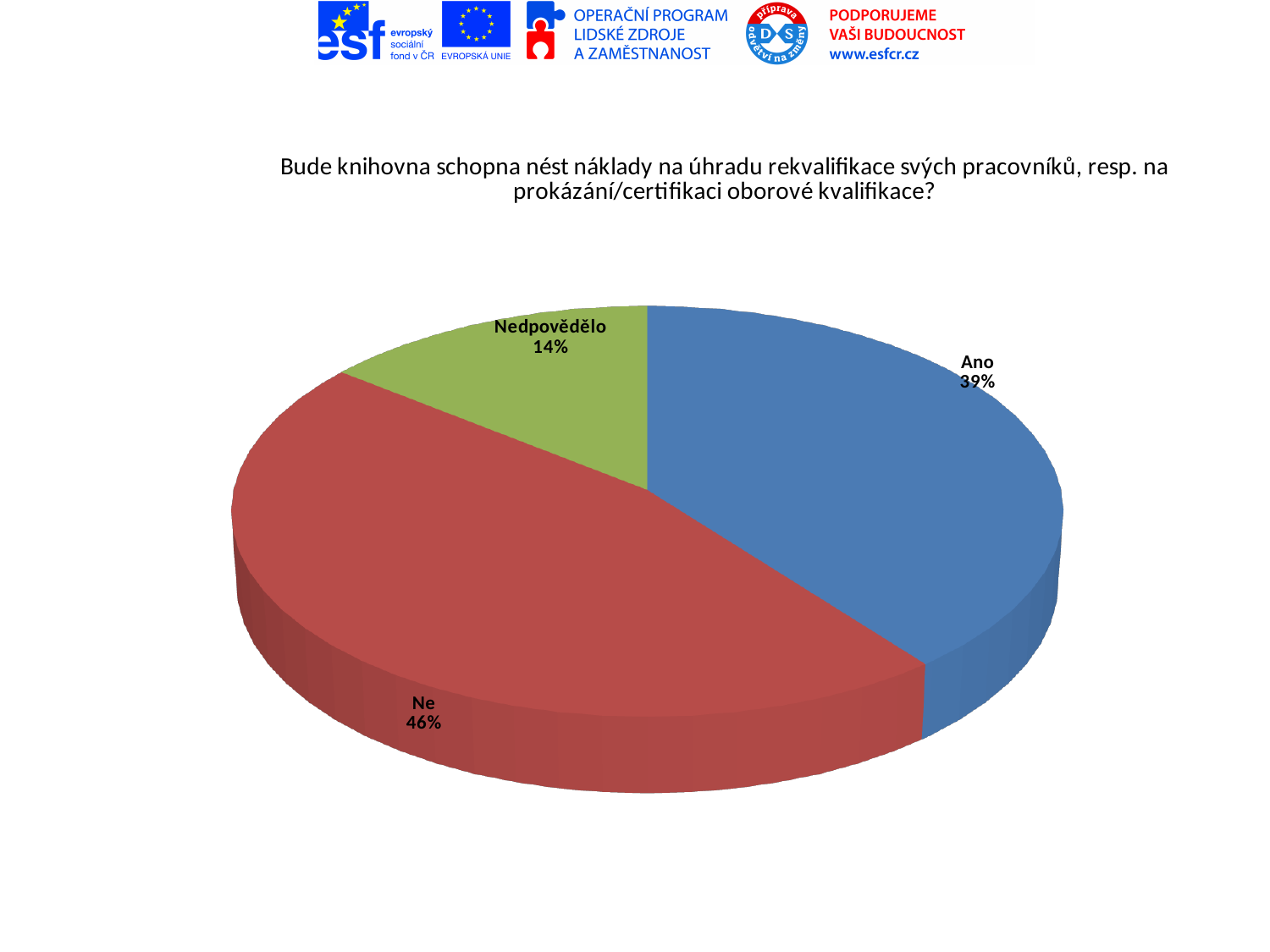
What kind of chart is shown on the slide? Pie chart What is the difference in percentage points between "Ne" and "Ano"? 7 What share of the pie does "Ano" represent? 39% Which category has the smallest slice of the pie? Nedpovědělo What colour is the "Nedpovědělo" slice? Green What is the difference in percentage points between "Ano" and "Nedpovědělo"? 25 What share of the pie does "Ne" represent? 46% What colour is the "Ne" slice? Red What share of the pie does "Nedpovědělo" represent? 14% Which is larger, the share for "Ano" or the share for "Nedpovědělo"? Ano How many categories are shown in the pie chart? 3 Which category has the largest slice of the pie? Ne